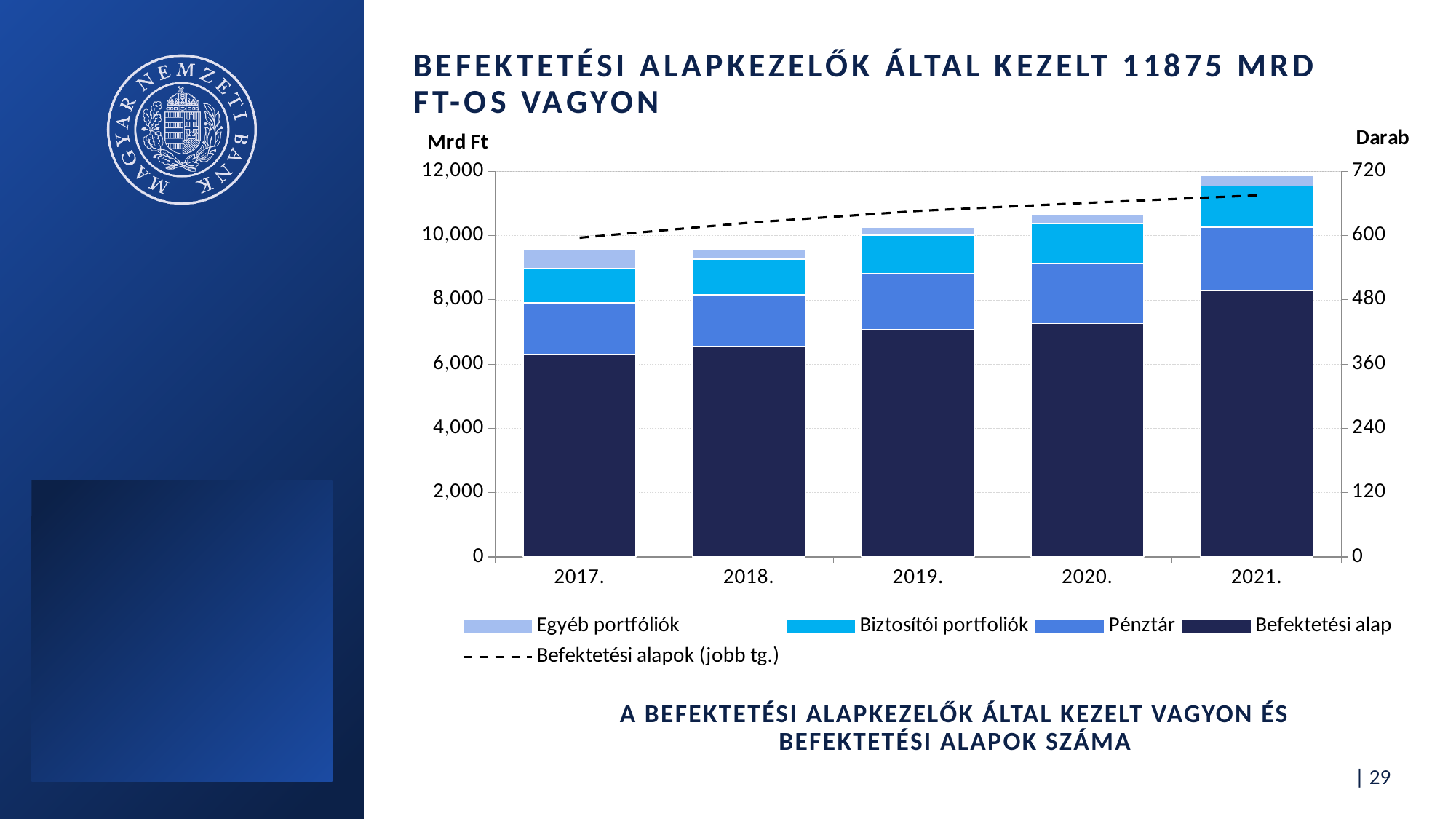
Which year has the highest total stacked bar? 2021. Is the Befektetési alapok (jobb tg.) value for 2021. greater or less than 600 on the right axis? greater How many years are shown on the x axis of the chart? 5 How many series does the chart's legend list? 5 Is the total stacked bar for 2021. greater or less than 10,000? greater Is the Befektetési alap value for 2017. greater or less than 6,000? greater Which is larger, the Befektetési alap value for 2021. or for 2017.? 2021. Does the Befektetési alapok (jobb tg.) dashed line rise or fall from 2017. to 2021.? rise What unit label is shown on the right-hand axis of the chart? Darab What kind of chart is shown on the slide? combination bar and line chart